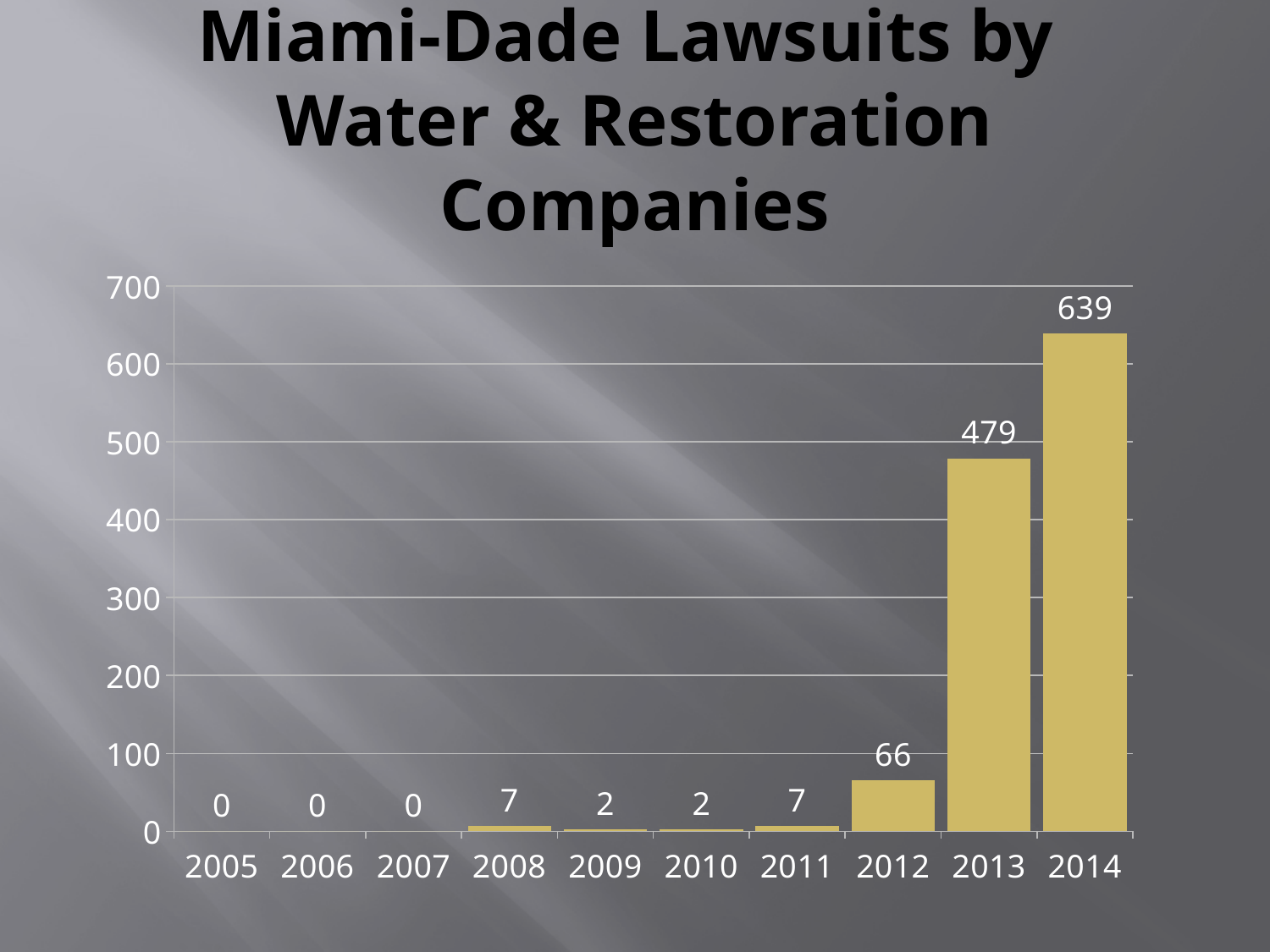
What is the difference between the values for 2014 and 2013? 160 Do the values generally rise or fall from 2011 to 2014? rise What kind of chart is this? bar chart Which year has the highest value? 2014 How many years are shown on the x axis? 10 What is the title of the chart? Miami-Dade Lawsuits by Water & Restoration Companies What is the value for 2013? 479 What is the value for 2014? 639 What is the value for 2012? 66 Is the value for 2013 greater or less than 400? greater Which is larger, the value for 2012 or the value for 2011? 2012 What is the value for 2008? 7